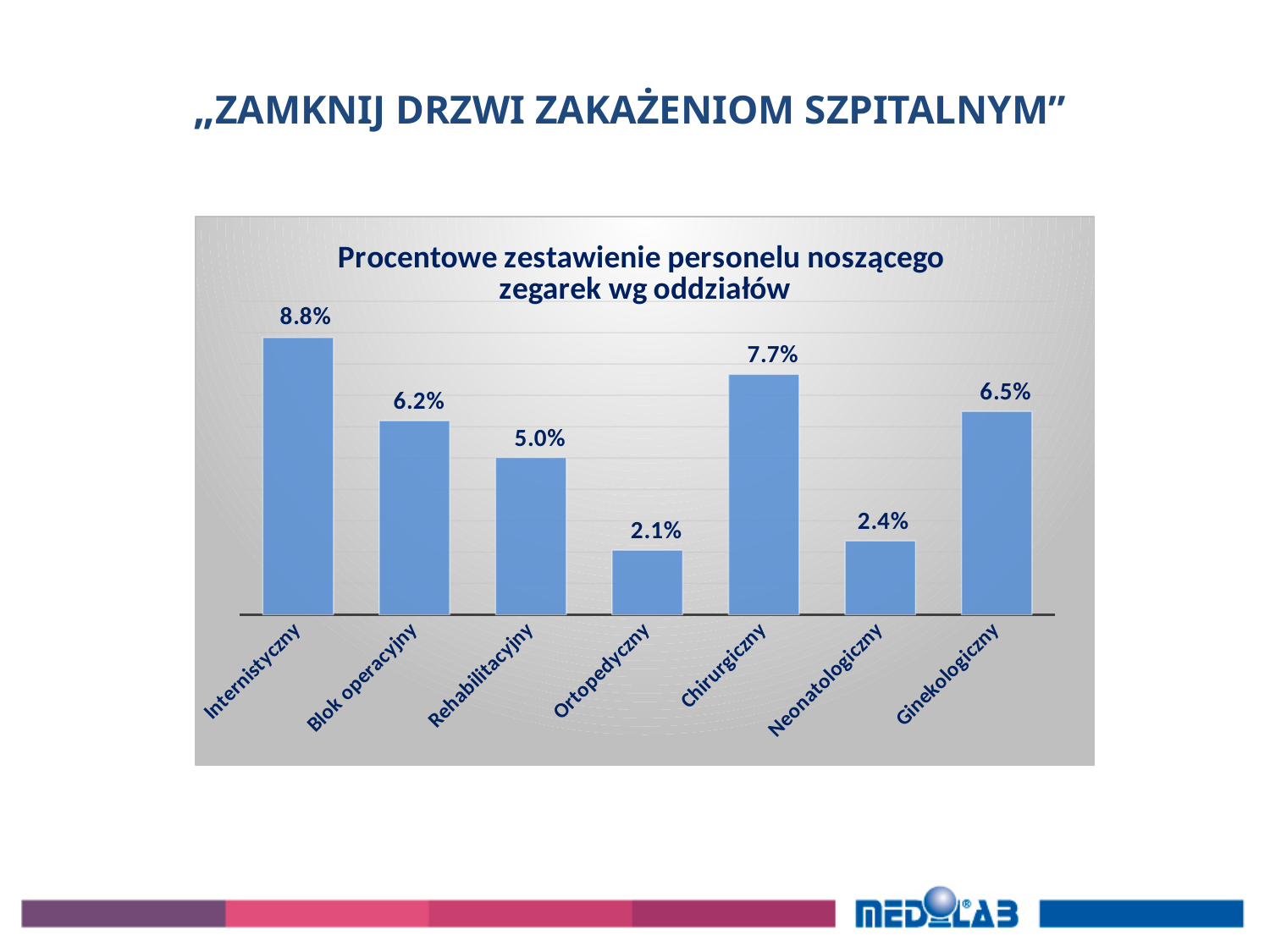
Which department has the lowest percentage? Ortopedyczny What is the difference between the values for Blok operacyjny and Rehabilitacyjny? 1.2% Which is larger, the value for Chirurgiczny or the value for Ginekologiczny? Chirurgiczny Which department has the highest percentage? Internistyczny What is the title of the chart? Procentowe zestawienie personelu noszącego zegarek wg oddziałów How many departments are shown on the chart? 7 What is the value for Ortopedyczny? 2.1% Which is larger, the value for Neonatologiczny or the value for Ortopedyczny? Neonatologiczny What kind of chart is shown on the slide? Bar chart What is the value for Internistyczny? 8.8% What is the value for Ginekologiczny? 6.5% What is the difference between the values for Internistyczny and Chirurgiczny? 1.1%